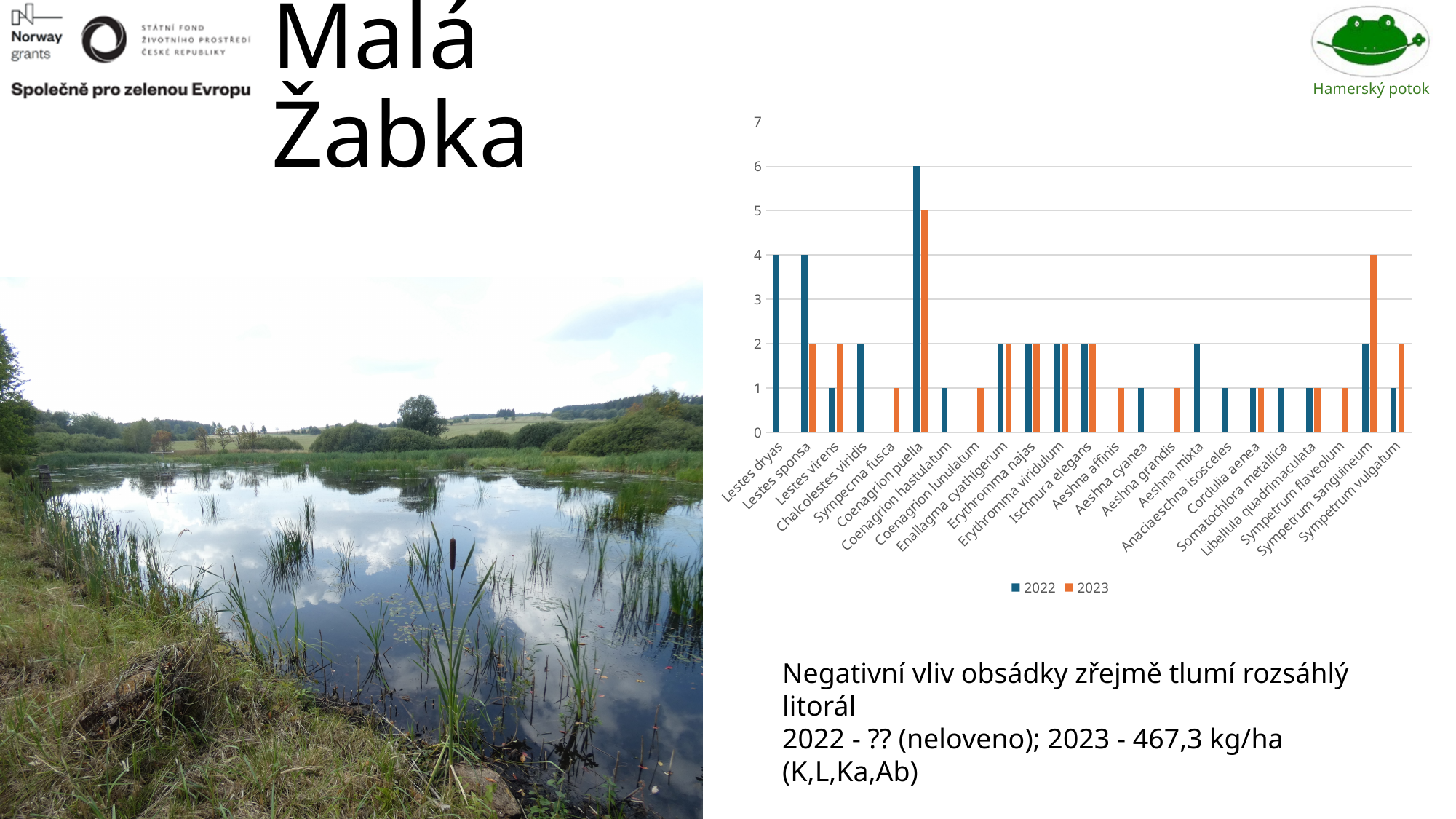
For Sympetrum sanguineum, which is larger: the 2022 value or the 2023 value? 2023 Is the 2022 value for Lestes sponsa greater or less than 3? greater What is the 2022 value for Lestes dryas? 4 How many series does the chart legend list? 2 What kind of chart is shown on the slide? bar chart What is the 2022 value for Coenagrion puella? 6 How many species categories are shown on the x axis of the chart? 23 What is the difference between the 2022 and 2023 values for Coenagrion puella? 1 What is the 2023 value for Sympetrum sanguineum? 4 Which series are listed in the chart legend? 2022 and 2023 Which species has the highest 2022 value? Coenagrion puella Which species has the highest 2023 value? Coenagrion puella